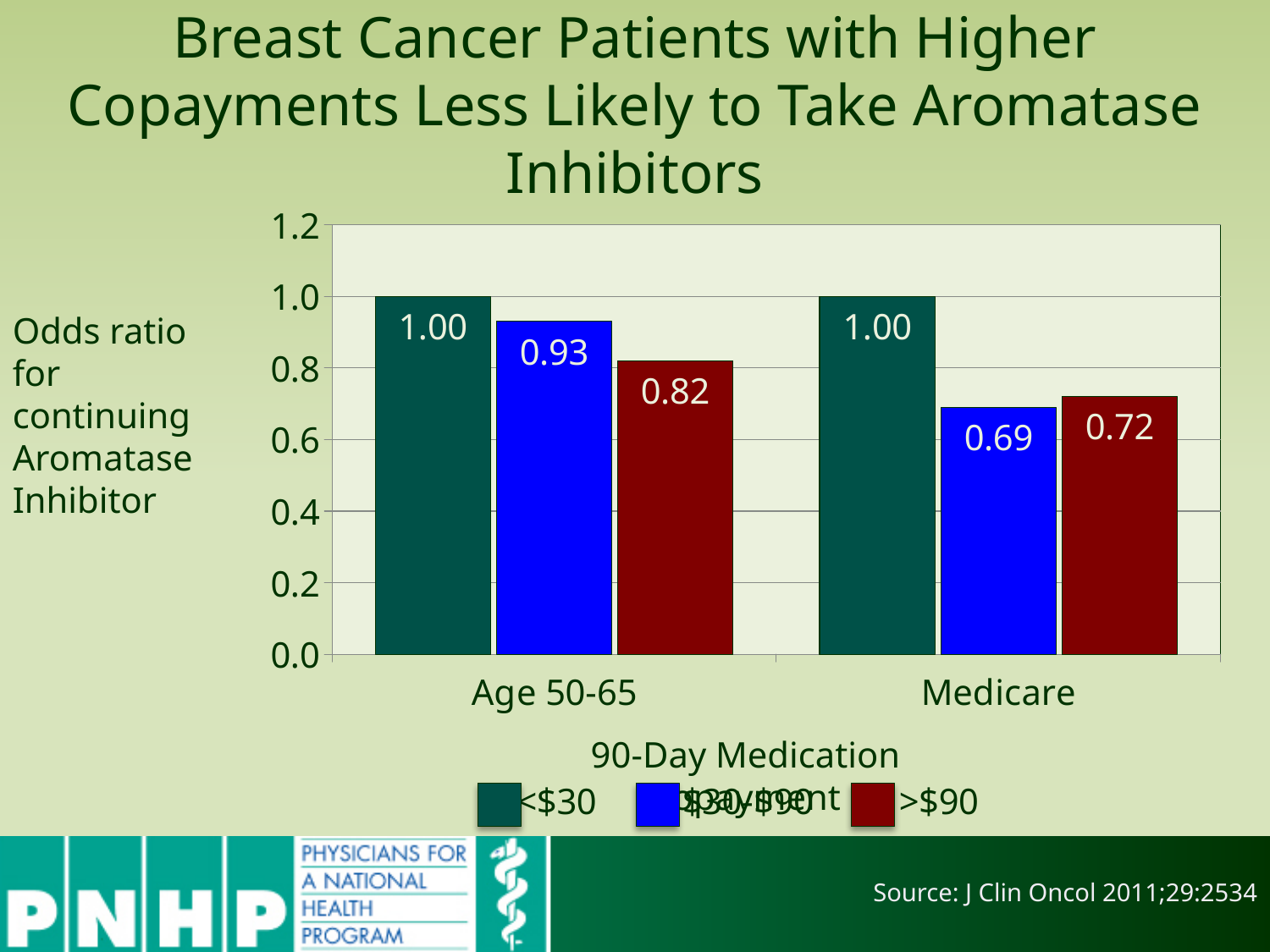
Is the value of the blue (middle) bar for Medicare greater or less than 0.8? less What is the odds ratio for the <$30 copayment group among patients aged 50-65? 1.00 For the Medicare group, how much higher is the >$90 bar than the blue (middle) bar? 0.03 What is the odds ratio for the >$90 copayment group among Medicare patients? 0.72 What is the value of the blue (middle) bar for the Medicare group? 0.69 Which age category contains the lowest bar on the chart? Medicare What kind of chart is shown on the slide? bar chart How many series does the legend list? 3 Is the >$90 odds ratio larger for Age 50-65 or for Medicare? Age 50-65 What is the odds ratio for the >$90 copayment group among patients aged 50-65? 0.82 What is the difference between the <$30 and >$90 odds ratios for the Age 50-65 group? 0.18 How many patient categories are shown on the x axis? 2